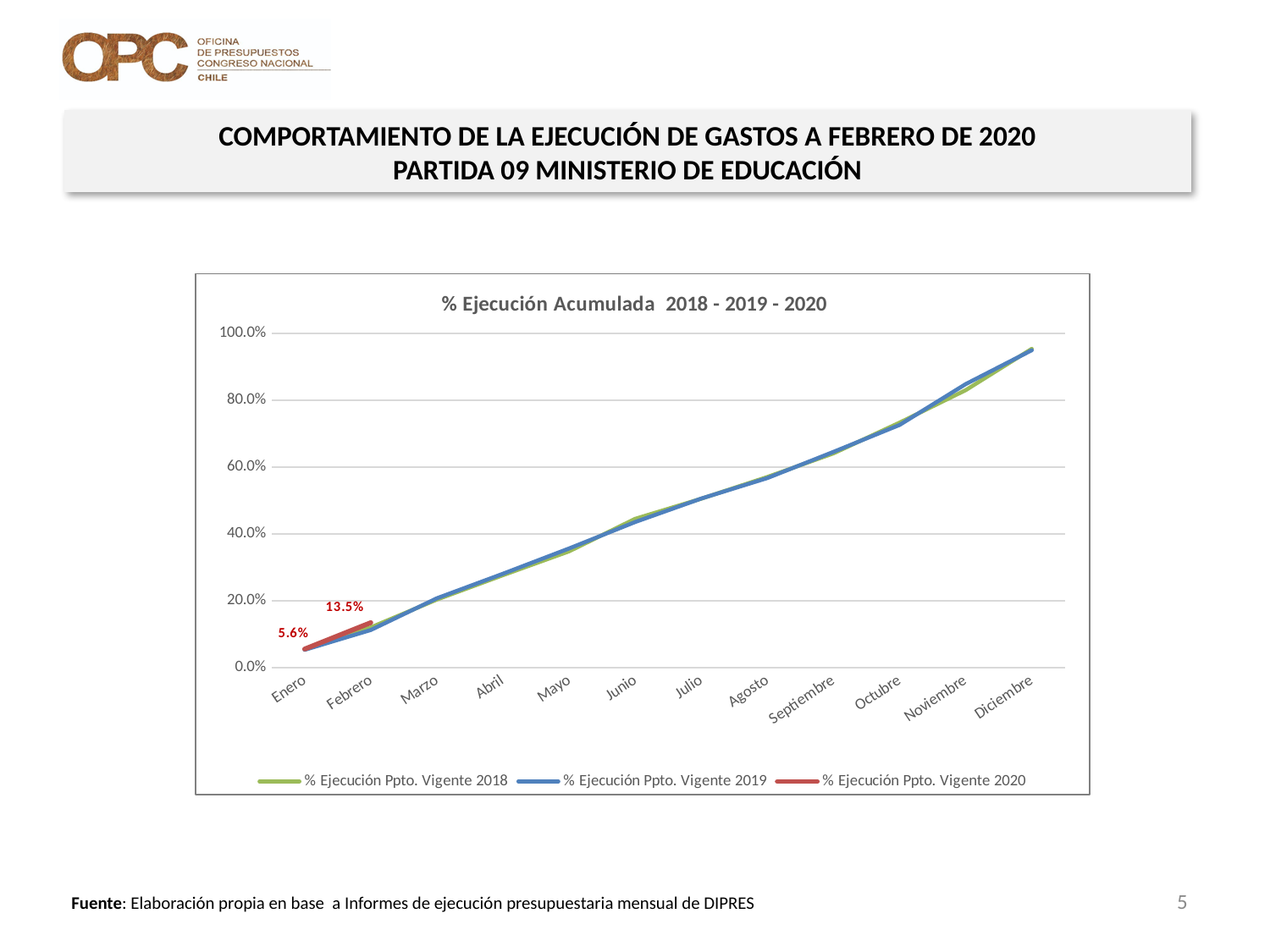
Do the values of the % Ejecución Ppto. Vigente 2019 series rise or fall from Enero to Diciembre? Rise What is the title of the chart? % Ejecución Acumulada 2018 - 2019 - 2020 What is the value for Febrero in the % Ejecución Ppto. Vigente 2020 series? 13.5% In the % Ejecución Ppto. Vigente 2020 series, which is larger, the Enero value or the Febrero value? Febrero How many months are shown on the x axis of the chart? 12 What is the value for Enero in the % Ejecución Ppto. Vigente 2020 series? 5.6% Is the Abril value for % Ejecución Ppto. Vigente 2018 greater or less than 20.0%? greater How many series does the chart legend list? 3 What is the difference between the Febrero and Enero values of the % Ejecución Ppto. Vigente 2020 series? 7.9 percentage points What kind of chart is shown on the slide? Line chart Is the Octubre value for % Ejecución Ppto. Vigente 2019 greater or less than 60.0%? greater Is the Diciembre value for % Ejecución Ppto. Vigente 2019 greater or less than 80.0%? greater